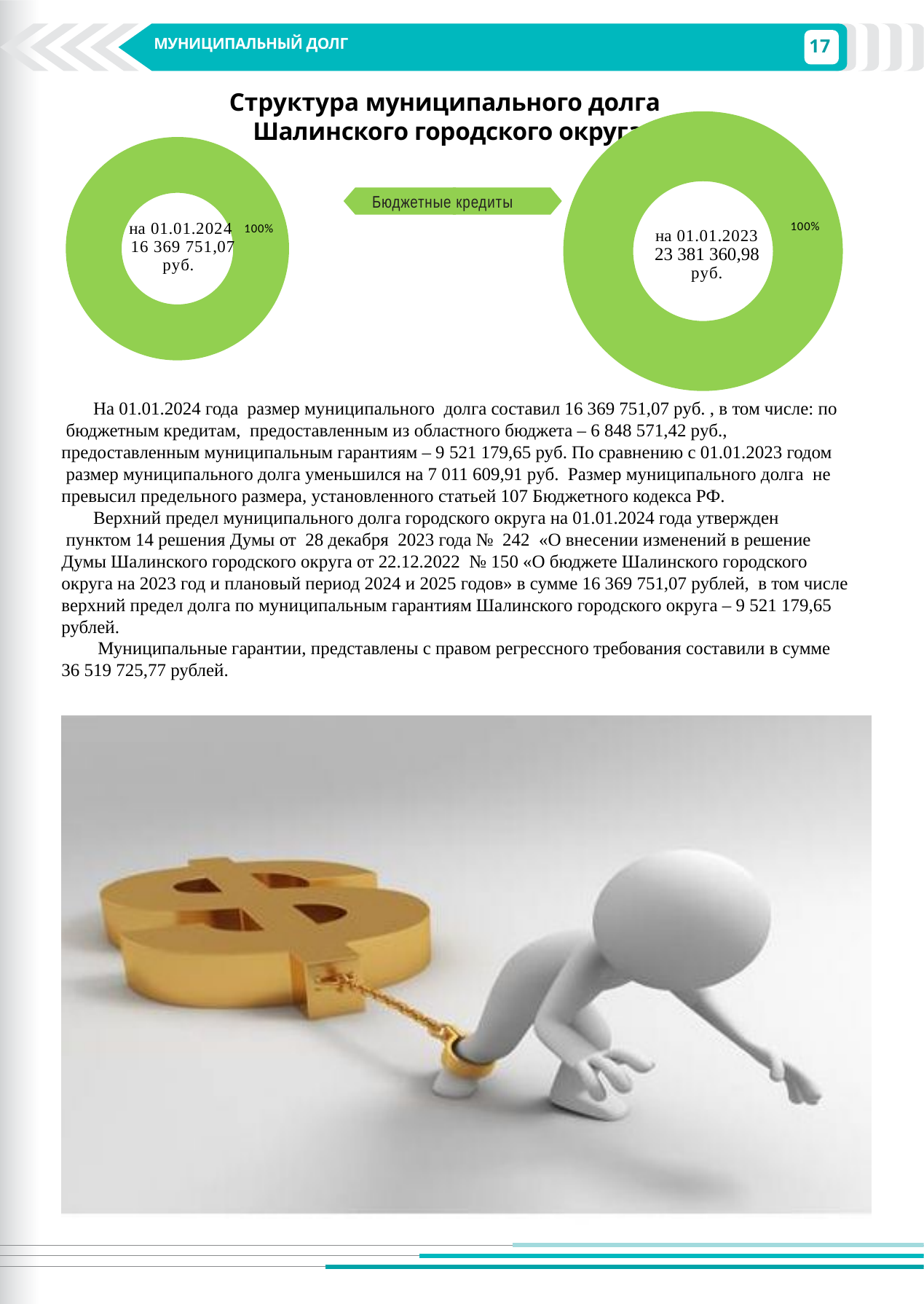
What debt amount is printed in the centre of the right donut chart (на 01.01.2023)? 23 381 360,98 руб. What kind of chart is used on the slide to show the structure of municipal debt? Pie (donut) chart What debt amount is printed in the centre of the left donut chart (на 01.01.2024)? 16 369 751,07 руб. In the right donut chart (на 01.01.2023), what share is shown for Бюджетные кредиты? 100% How many slices does the left donut chart (на 01.01.2024) contain? 1 By how much does the debt amount in the right donut chart (на 01.01.2023) exceed the amount in the left donut chart (на 01.01.2024)? 7 011 609,91 руб. What is the title above the donut charts? Структура муниципального долга Шалинского городского округа What category label is shown in the green arrow between the two donut charts? Бюджетные кредиты In the left donut chart (на 01.01.2024), what share is shown for Бюджетные кредиты? 100% Which date has the larger municipal debt amount according to the two donut charts, 01.01.2024 or 01.01.2023? 01.01.2023 How many donut charts are shown on the slide? 2